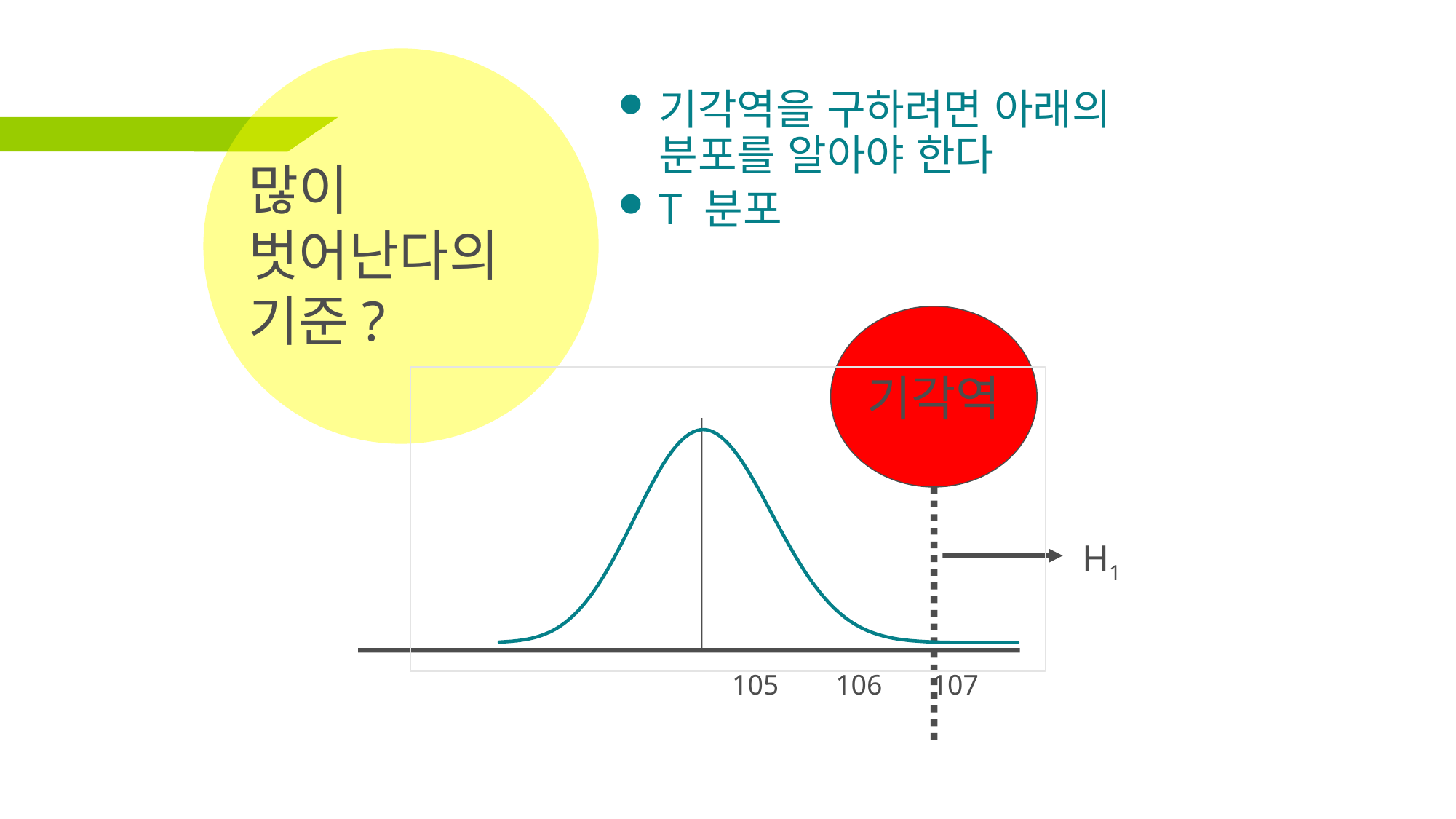
What label is written in the red circle above the dashed line? 기각역 Does the curve rise or fall as the x axis goes from 105 to 107? fall Is the curve higher at 105 or at 107? 105 How many numeric tick labels are shown on the x axis of the chart? 3 What label is attached to the arrow pointing right from the dashed line? H1 Which x-axis tick does the dashed vertical line sit at? 107 Is the curve higher at 106 or at 107? 106 What kind of chart is shown on the slide? line chart